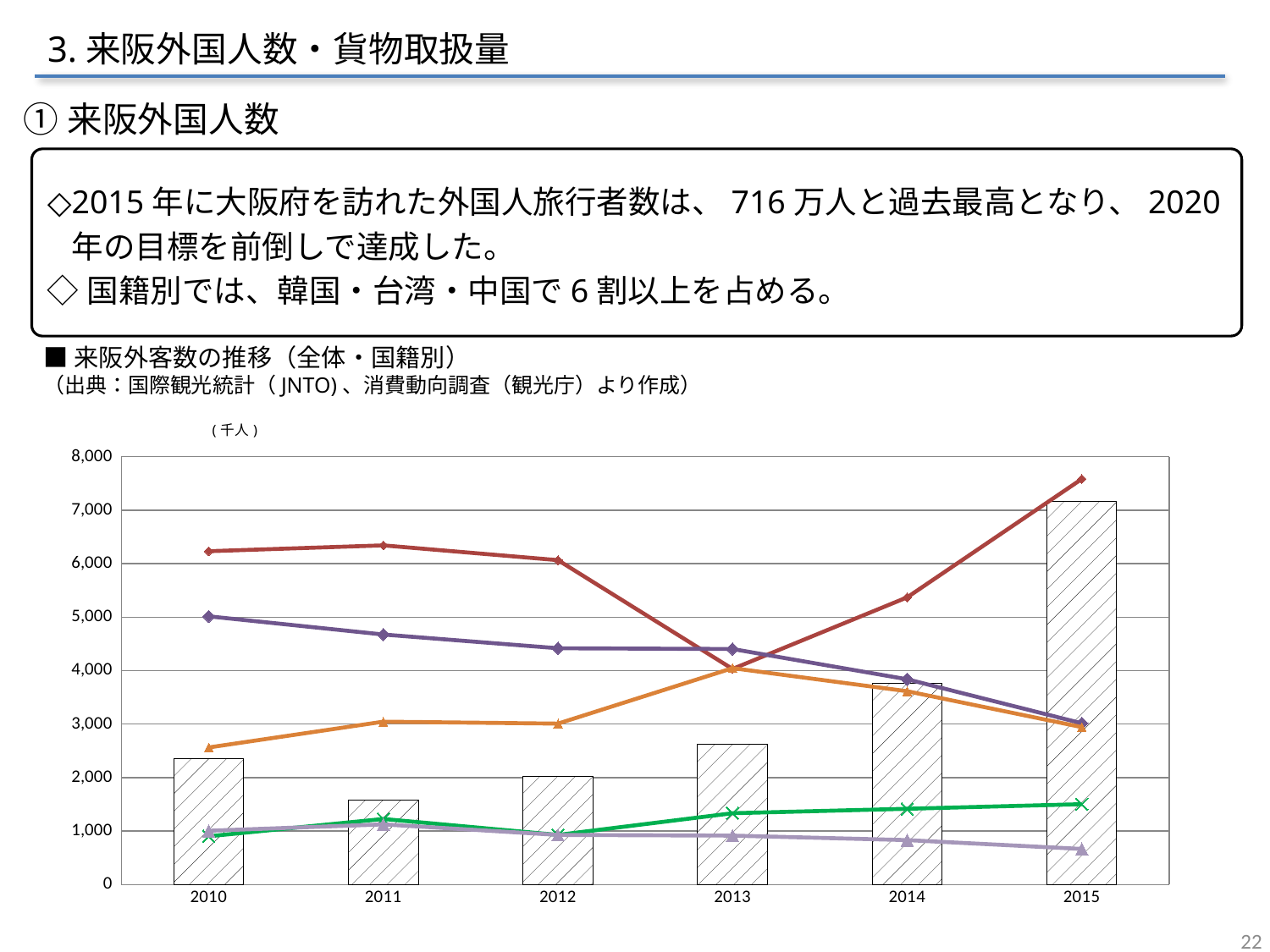
What kind of chart is shown on the slide? A combined bar and line chart Is the hatched bar for 2011 greater or less than 2,000? less Is the hatched bar for 2014 greater or less than 4,000? less Which year has the shortest hatched bar? 2011 Is the hatched bar for 2015 greater or less than 6,000? greater Which hatched bar is taller, 2013 or 2014? 2014 What is the title of the chart? 来阪外客数の推移（全体・国籍別） Do the hatched bars rise or fall from 2012 to 2015? rise Which year has the tallest hatched bar? 2015 How many years are shown on the x axis of the chart? 6 What unit is shown above the vertical axis of the chart? 千人